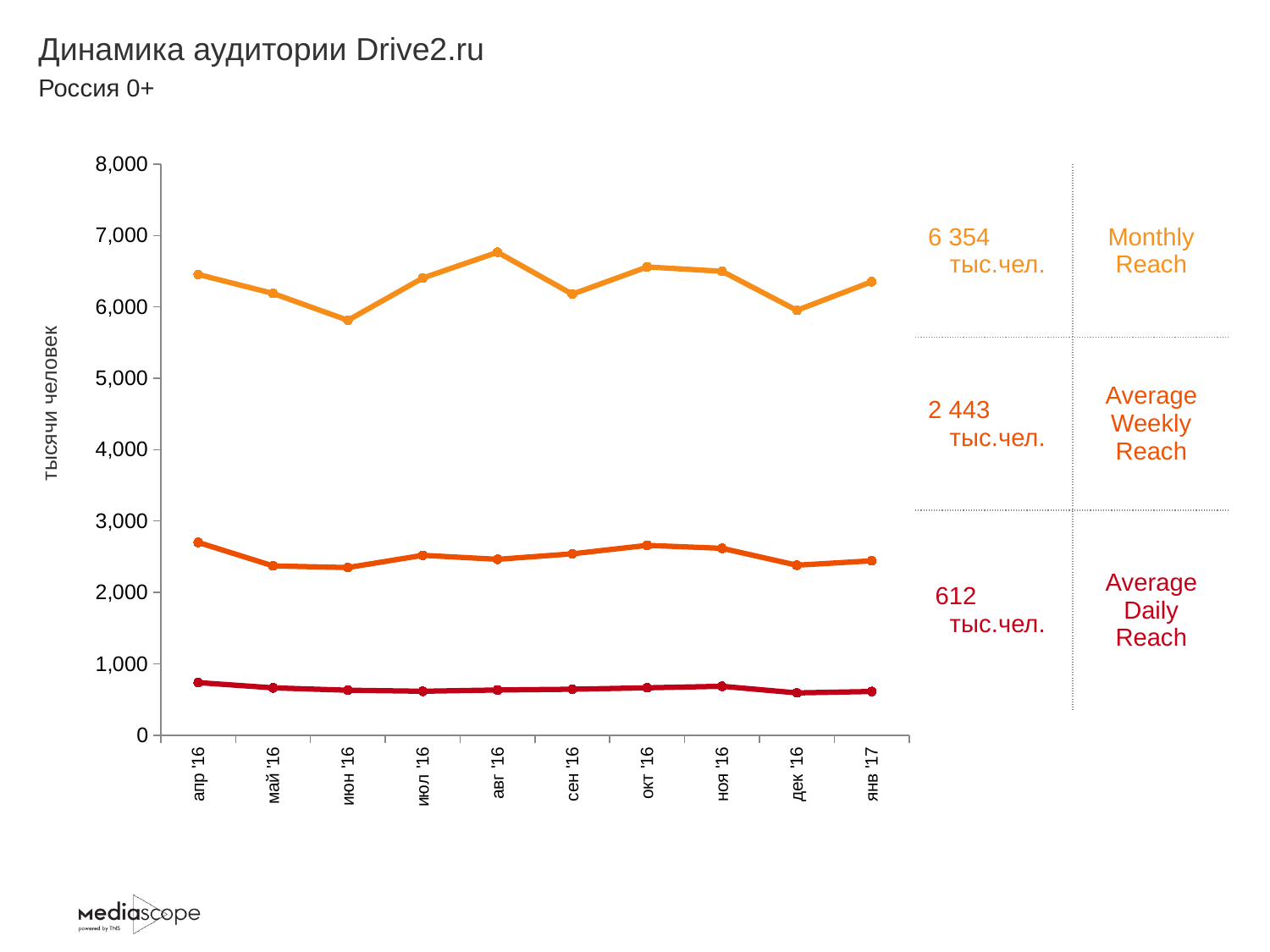
What Monthly Reach value is printed in the panel to the right of the chart? 6 354 тыс.чел. Is the Monthly Reach value for авг '16 greater or less than 6,000? greater In which month is Monthly Reach highest? авг '16 Is the Average Daily Reach value for апр '16 greater or less than 1,000? less How many series are plotted on the chart? 3 How many months are plotted along the x axis? 10 Is the Average Weekly Reach value for апр '16 greater or less than 3,000? less What type of chart is shown on the slide? line chart In which month is Monthly Reach lowest? июн '16 Does Average Daily Reach rise or fall from апр '16 to май '16? fall Which month has the higher Monthly Reach, апр '16 or май '16? апр '16